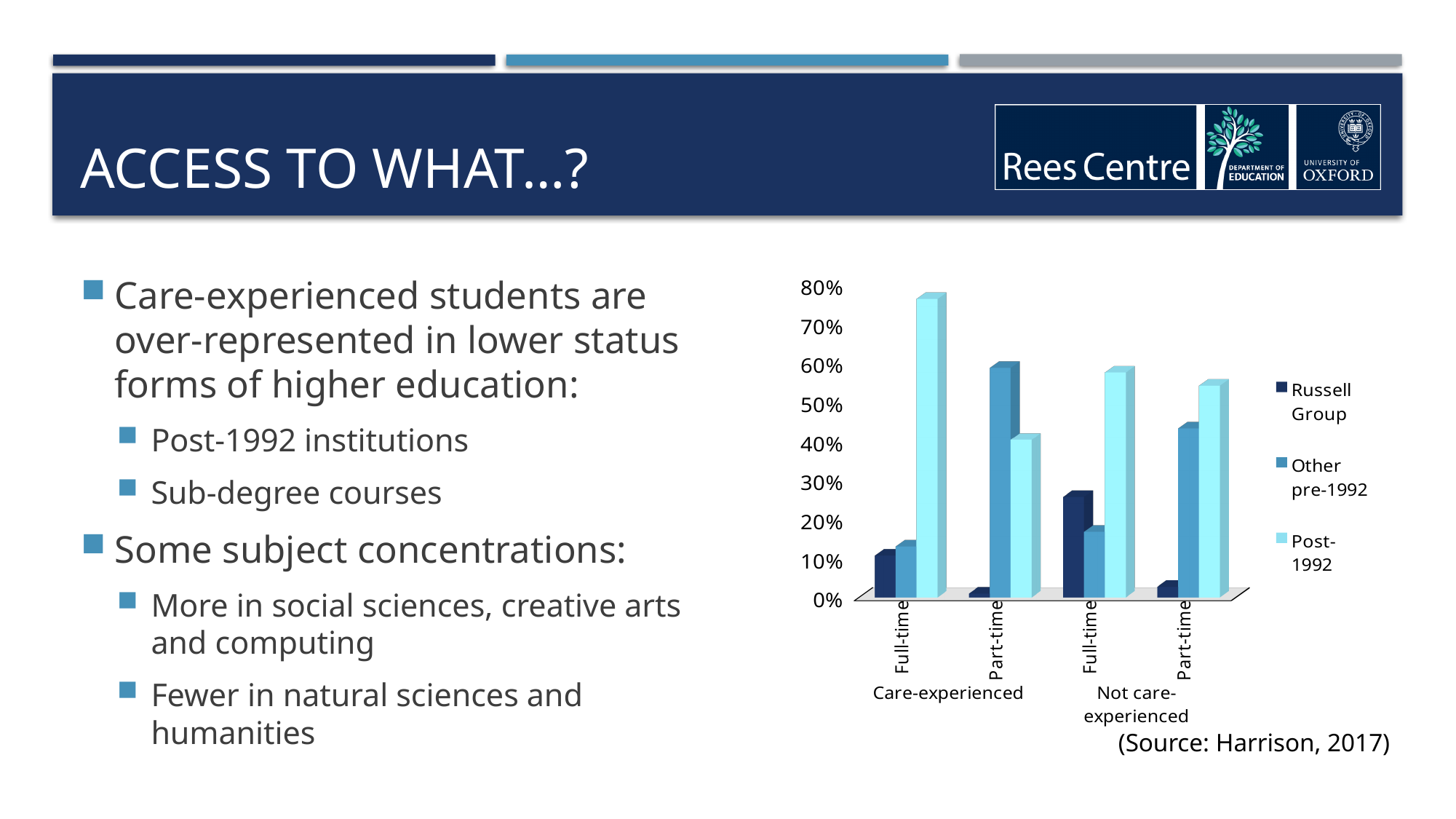
Which series has the lowest value for Care-experienced Part-time students? Russell Group What source is cited below the chart? Harrison, 2017 Which is larger for Not care-experienced Full-time students: the Russell Group value or the Other pre-1992 value? Russell Group How many bar groups (categories) are shown along the x axis of the chart? 4 Which is larger for Care-experienced Part-time students: the Other pre-1992 value or the Post-1992 value? Other pre-1992 How many series does the chart legend list? 3 Is the Post-1992 value for Care-experienced Full-time students greater or less than 70%? greater Is the Russell Group value for Not care-experienced Full-time students greater or less than 20%? greater Which series has the highest value for Care-experienced Full-time students? Post-1992 Is the Russell Group value for Care-experienced Full-time students greater or less than 20%? less What kind of chart is shown on the slide? bar chart